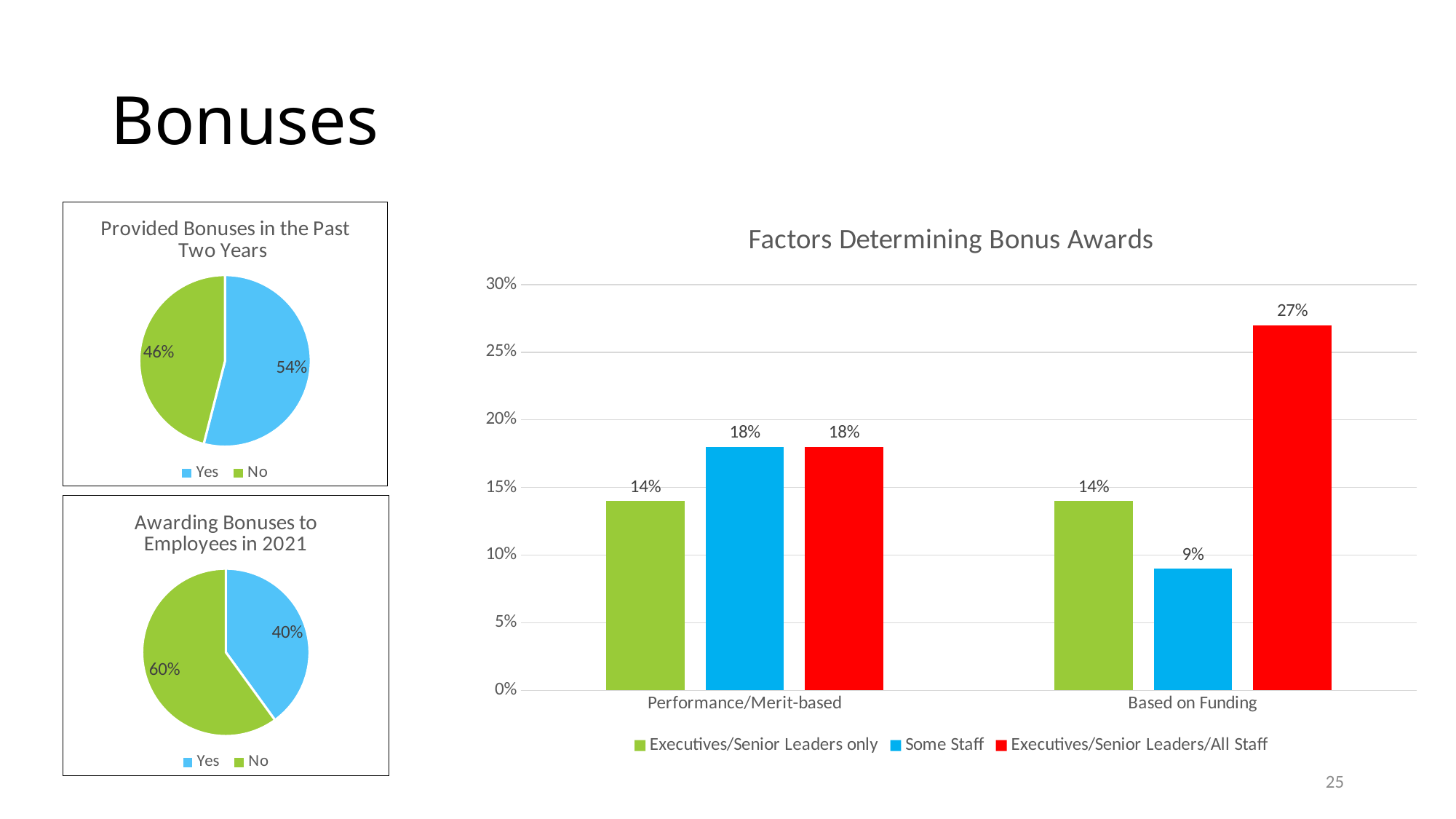
In the 'Awarding Bonuses to Employees in 2021' pie chart, what share is labelled No? 60% In the 'Awarding Bonuses to Employees in 2021' pie chart, which slice is larger, Yes or No? No In the 'Provided Bonuses in the Past Two Years' pie chart, what share is labelled No? 46% In the 'Factors Determining Bonus Awards' chart, what is the difference between the Executives/Senior Leaders/All Staff value and the Some Staff value under Based on Funding? 18% In the 'Factors Determining Bonus Awards' chart, which series has the lowest value under Based on Funding? Some Staff In the 'Factors Determining Bonus Awards' chart, what is the value for Some Staff under Performance/Merit-based? 18% In the 'Factors Determining Bonus Awards' chart, which colour represents Some Staff? Blue In the 'Provided Bonuses in the Past Two Years' pie chart, what share is labelled Yes? 54% What kind of chart is 'Factors Determining Bonus Awards'? Bar chart In the 'Factors Determining Bonus Awards' chart, how many categories are shown on the x axis? 2 In the 'Factors Determining Bonus Awards' chart, how many series does the legend list? 3 In the 'Factors Determining Bonus Awards' chart, what is the value for Executives/Senior Leaders/All Staff under Based on Funding? 27%